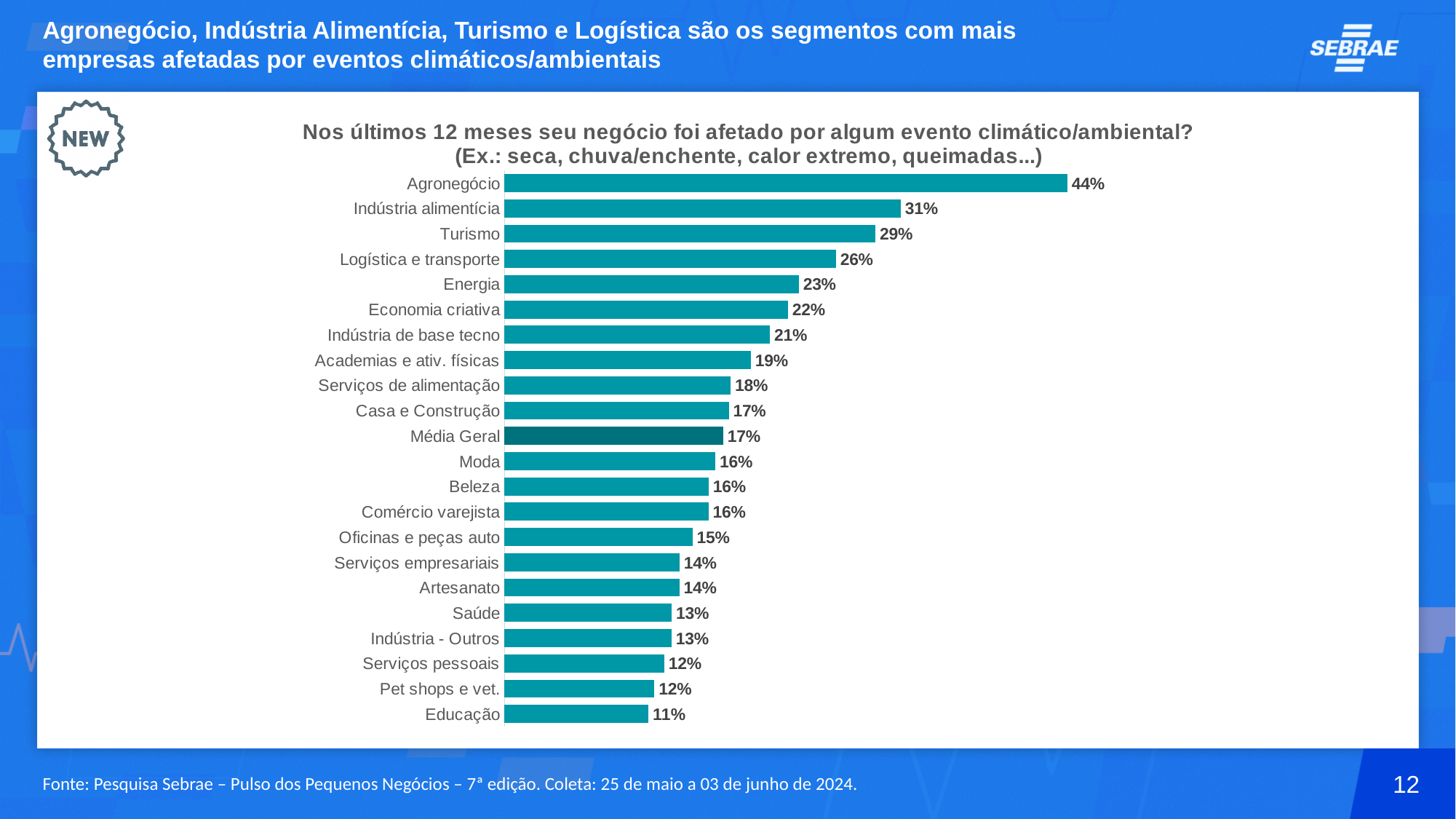
Which category has the lowest value? Educação Which category has the highest value? Agronegócio How many categories are shown in the chart? 22 What is the value for Educação? 11% What is the difference between the values for Turismo and Média Geral? 12% Which bar is shown in a darker colour than the others? Média Geral What is the value for Agronegócio? 44% What is the value for Logística e transporte? 26% What is the difference between the values for Agronegócio and Indústria alimentícia? 13% Which is larger, the value for Energia or the value for Economia criativa? Energia What is the value for Média Geral? 17% What kind of chart is shown on the slide? Bar chart